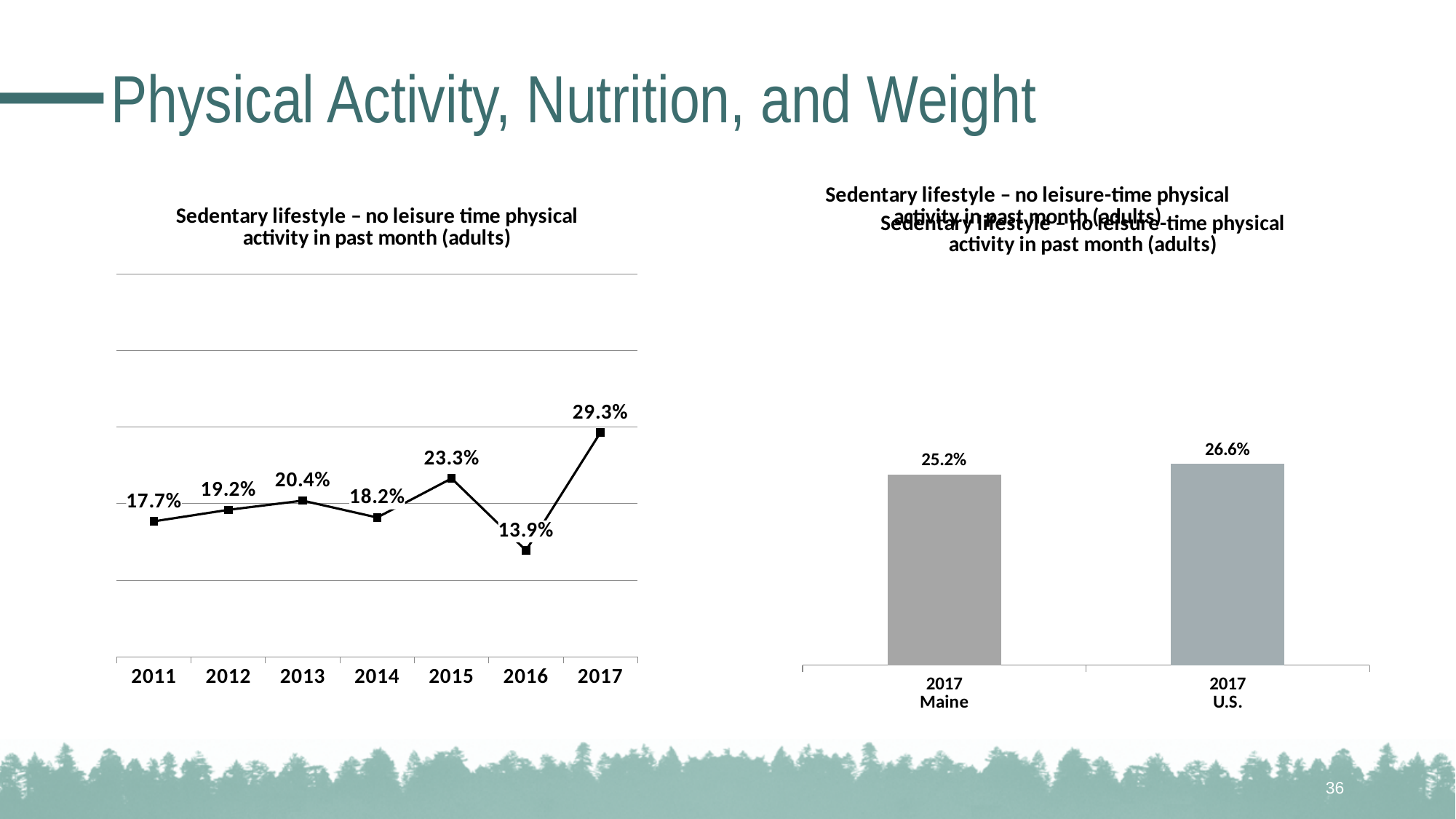
In the line chart on the left, how many years are plotted? 7 What type of chart is shown on the right side of the slide? bar chart In the line chart on the left, is the value for 2013 larger or smaller than the value for 2014? larger In the bar chart on the right, what is the value for 2017 Maine? 25.2% In the line chart on the left, which year has the highest value? 2017 In the bar chart on the right, what is the difference between the U.S. value and the Maine value? 1.4 percentage points In the line chart on the left, which year has the lowest value? 2016 In the line chart on the left, what is the value for 2017? 29.3% In the line chart on the left, what is the difference between the 2017 value and the 2016 value? 15.4 percentage points In the bar chart on the right, what is the value for 2017 U.S.? 26.6% In the line chart on the left, what is the value for 2011? 17.7% In the line chart on the left, what is the value for 2015? 23.3%